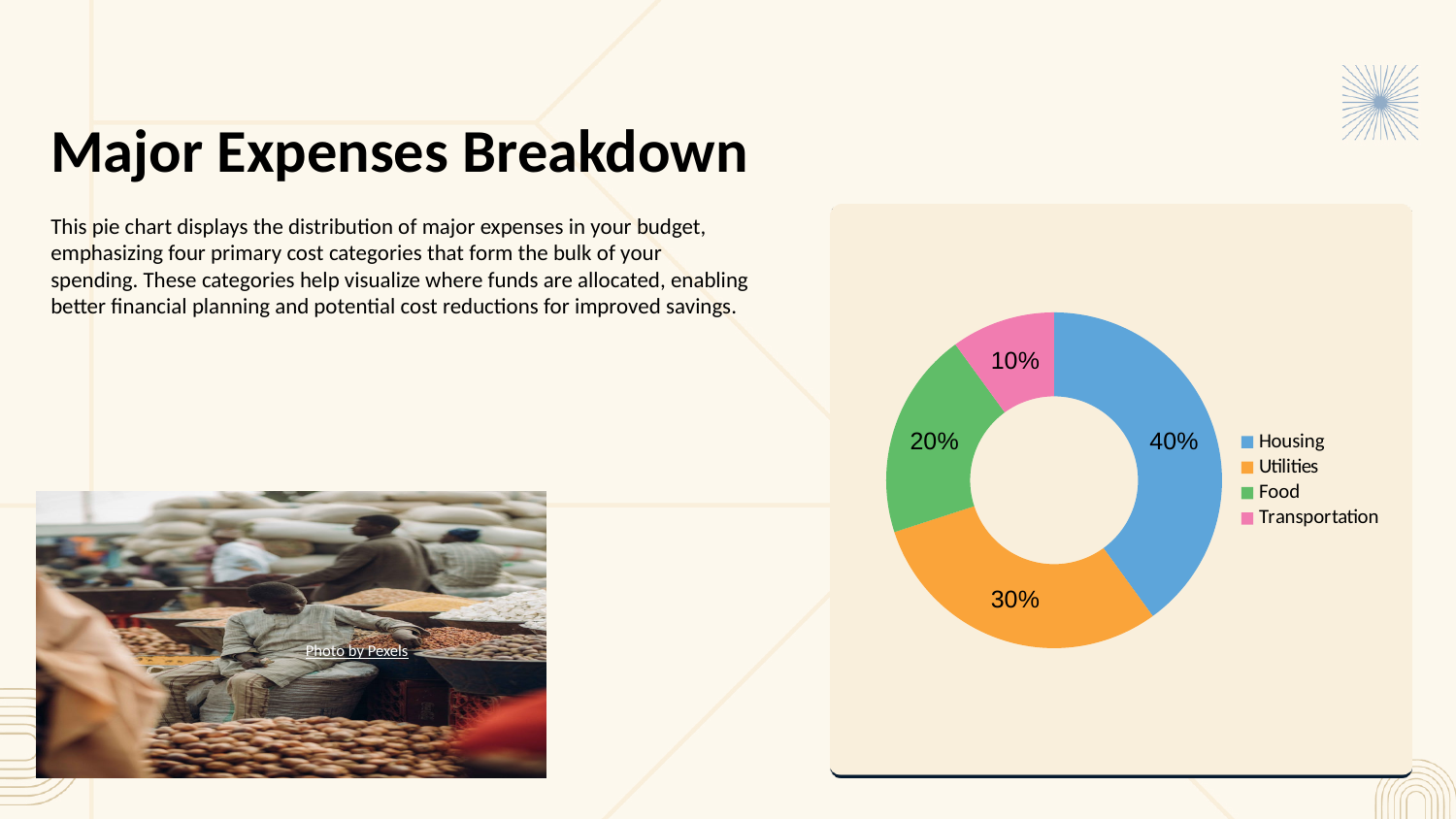
How many expense categories are shown in the chart? 4 What is the combined share of Housing and Utilities? 70% Which is larger, the Utilities share or the Transportation share? Utilities What share of expenses does Utilities account for? 30% What kind of chart is shown on the slide? Pie chart (doughnut) What is the difference between the Housing share and the Food share? 20% What share of expenses does Housing account for? 40% What share of expenses does Transportation account for? 10% Which expense category has the largest share? Housing Which colour represents Food in the chart? Green What share of expenses does Food account for? 20% Which expense category has the smallest share? Transportation